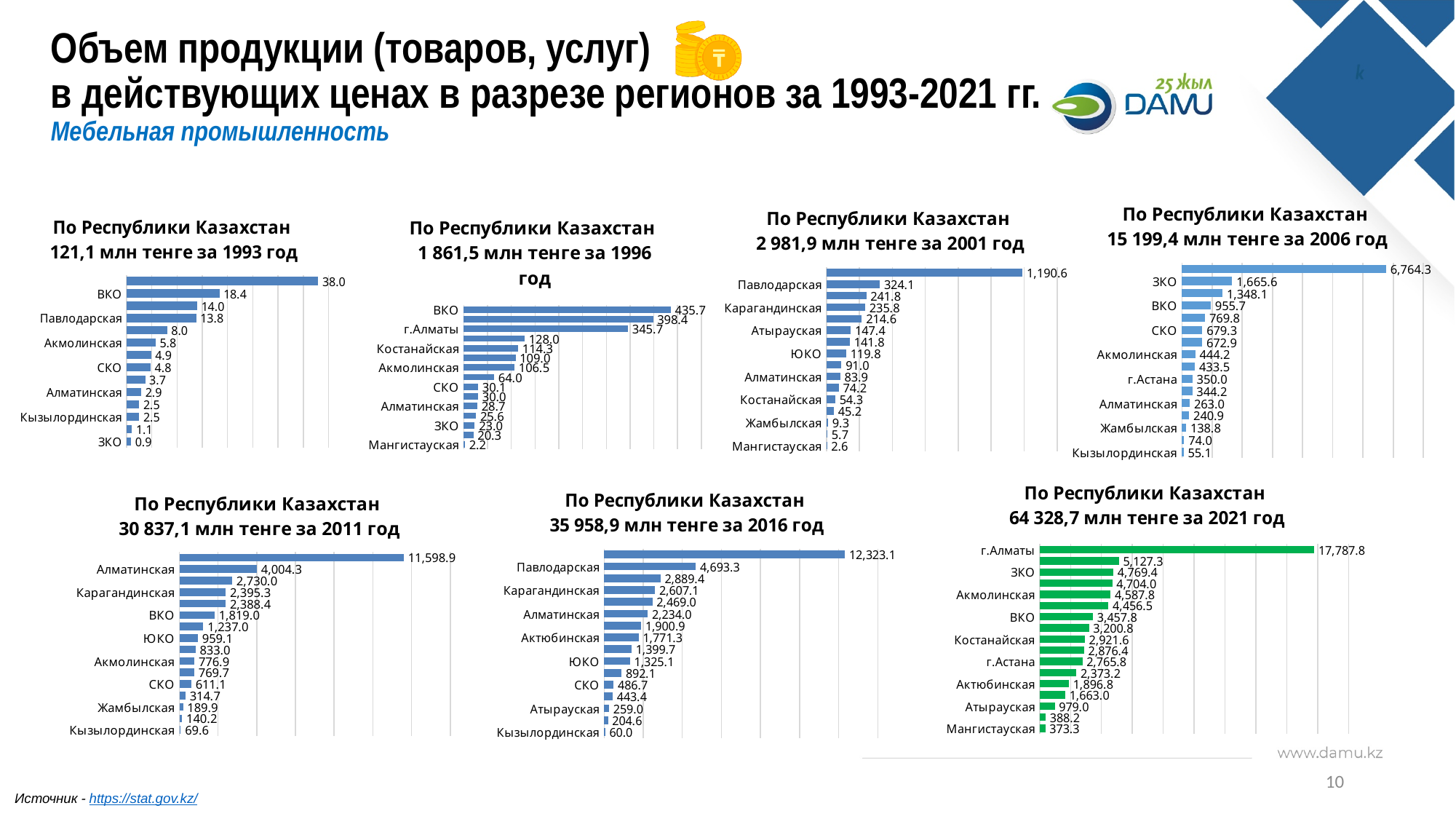
In the 2021 chart (bottom right), what is the value for г.Алматы? 17,787.8 What kind of chart is used for the 2021 data (bottom right)? Bar chart In the 1993 chart (top left), what is the value for ВКО? 18.4 In the 2016 chart (bottom middle), what is the value for Павлодарская? 4,693.3 In the 2021 chart (bottom right), which region has the highest value? г.Алматы In the 2011 chart (bottom left), what is the value for Алматинская? 4,004.3 How many charts are on the slide? 7 In the 2006 chart (top right), what is the value for ЗКО? 1,665.6 In the 2016 chart (bottom middle), which is larger: Павлодарская or Карагандинская? Павлодарская What colour are the bars in the 2021 chart (bottom right)? Green In the 2021 chart (bottom right), which labelled region has the lowest value? Мангистауская In the 2021 chart (bottom right), what is the difference between the values for г.Алматы and ЗКО? 13,018.4